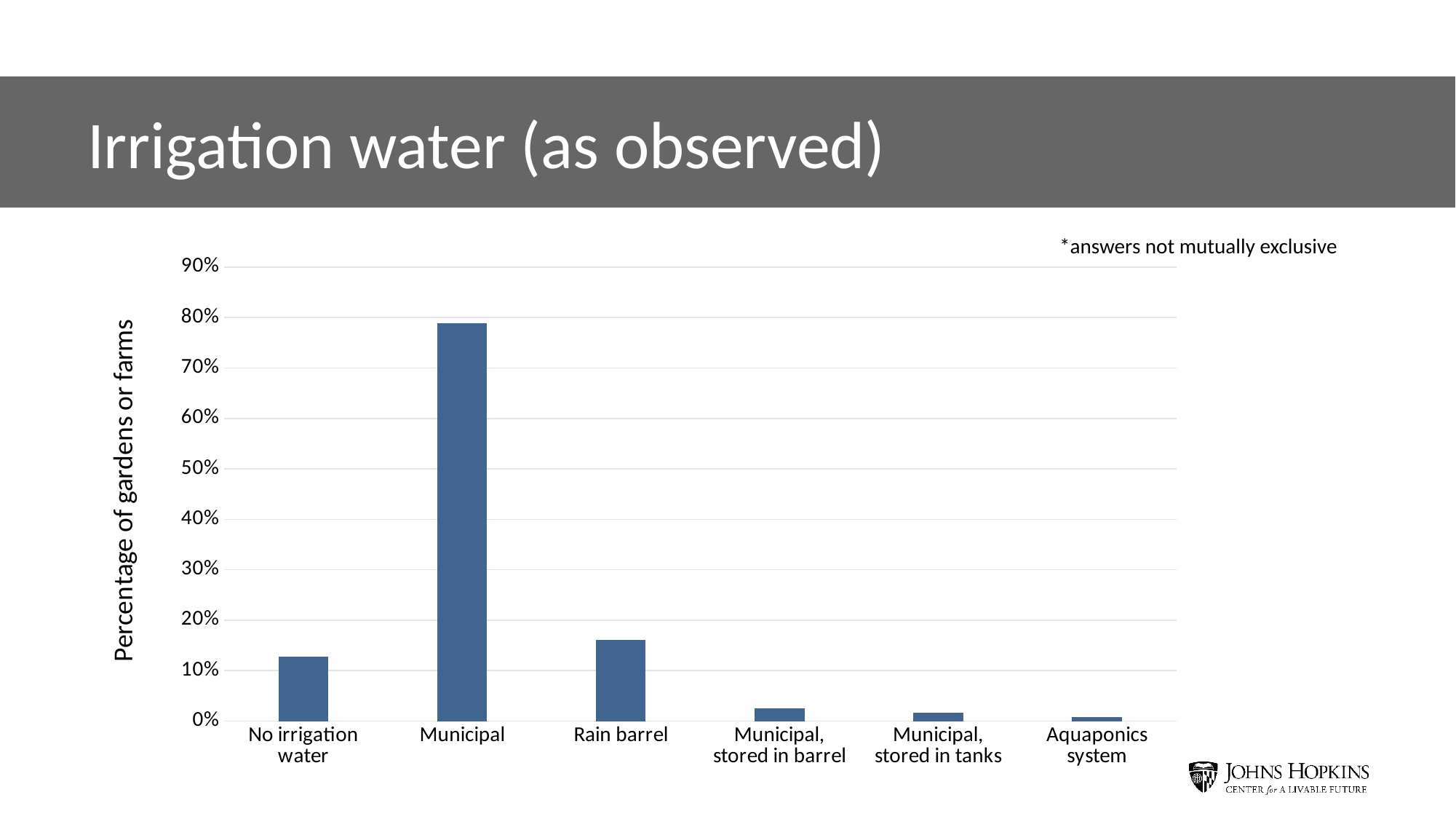
What kind of chart is shown on the slide? bar chart Is the value for Municipal, stored in barrel greater or less than 10%? less What is the label on the vertical axis of the chart? Percentage of gardens or farms Which category has the lowest percentage of gardens or farms? Aquaponics system Is the value for Municipal greater or less than 70%? greater Which category has the highest percentage of gardens or farms? Municipal Which is larger, the value for Rain barrel or the value for No irrigation water? Rain barrel Is the value for No irrigation water greater or less than 20%? less Which is larger, the value for Municipal or the value for Rain barrel? Municipal How many categories are shown on the x axis of the chart? 6